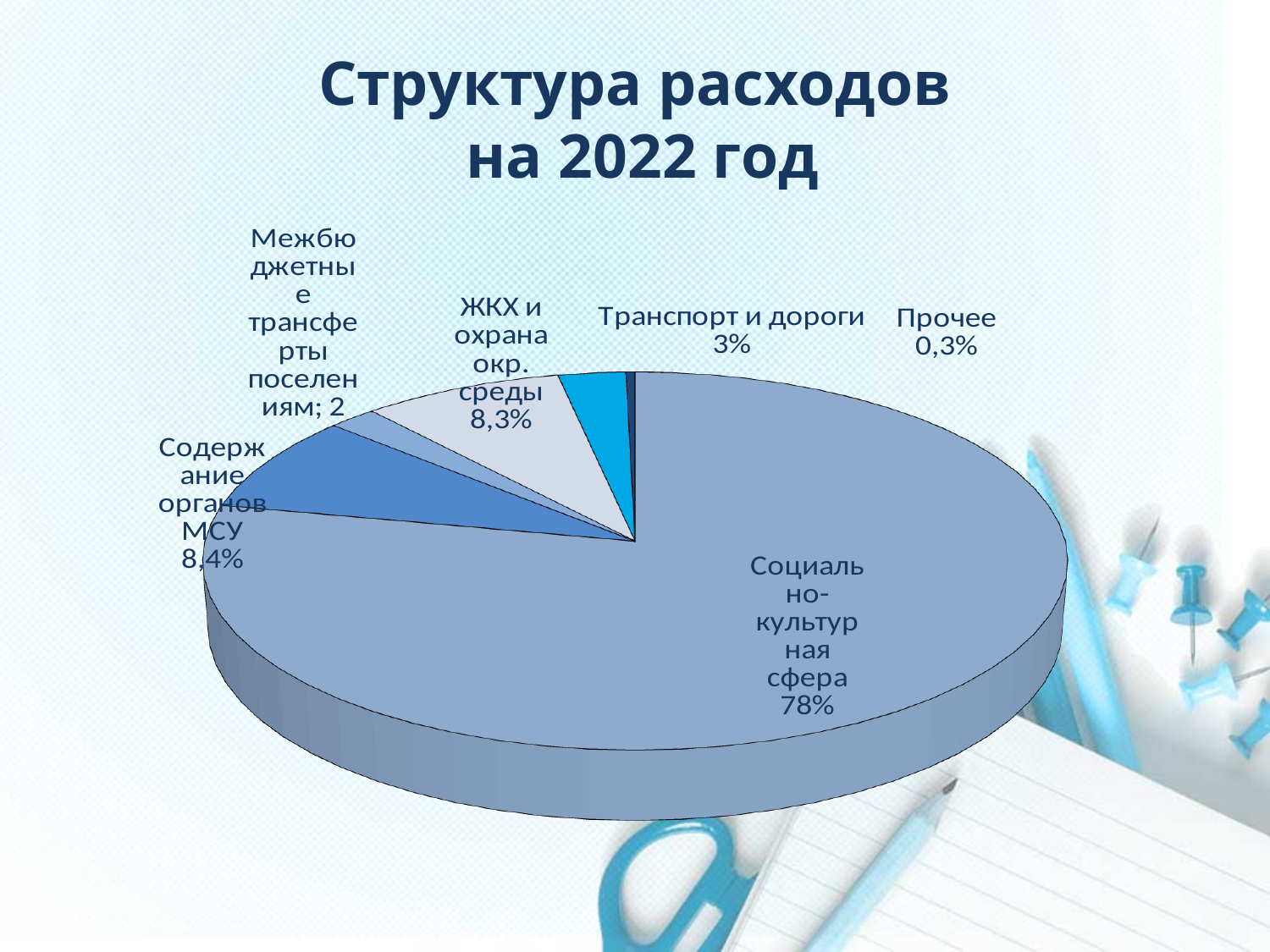
What value is shown for Межбюджетные трансферты поселениям? 2 What is the value for Прочее? 0,3% What is the title of the chart? Структура расходов на 2022 год What is the value for Содержание органов МСУ? 8,4% What is the value for Транспорт и дороги? 3% Which category has the smallest share of expenditures? Прочее What share of expenditures is Социально-культурная сфера? 78% What type of chart is shown on the slide? pie chart What is the difference between the shares of Социально-культурная сфера and Транспорт и дороги? 75% What is the value for ЖКХ и охрана окр. среды? 8,3% How many slices does the pie chart have? 6 Which category has the largest share of expenditures? Социально-культурная сфера